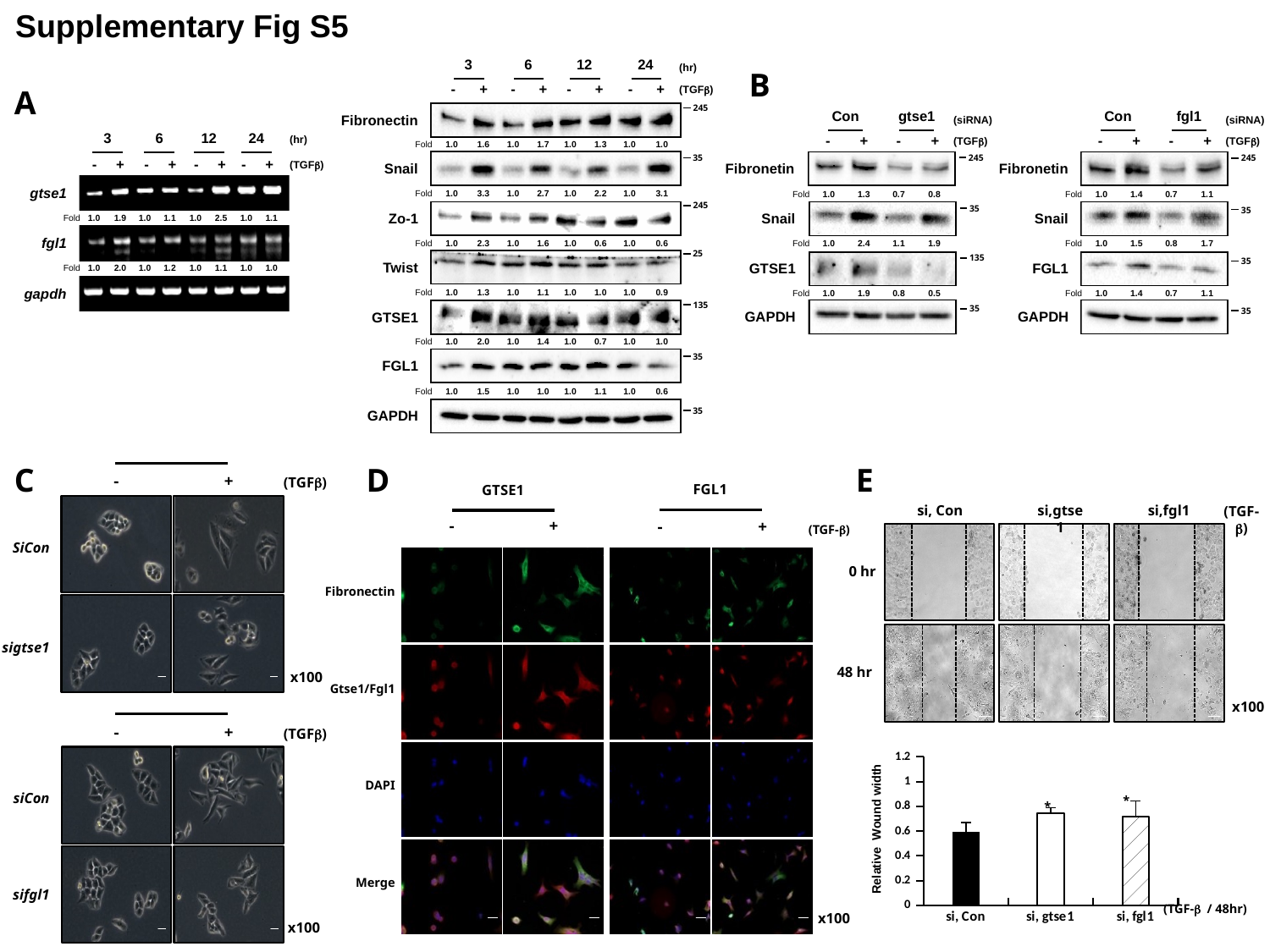
What kind of chart is shown in panel E at the bottom right of the slide? bar chart In the bar chart in panel E, which category has the lowest relative wound width? si, Con In the bar chart in panel E, is the value for si, gtse1 greater or less than 1? less In the bar chart in panel E, which is larger, the value for si, Con or the value for si, gtse1? si, gtse1 What is the highest tick value shown on the y axis of the bar chart in panel E? 1.2 What is the y-axis label of the bar chart in panel E? Relative Wound width In the bar chart in panel E, is the value for si, Con greater or less than 0.8? less In the bar chart in panel E, is the value for si, fgl1 greater or less than 0.6? greater In the bar chart in panel E, how many categories are plotted on the x axis? 3